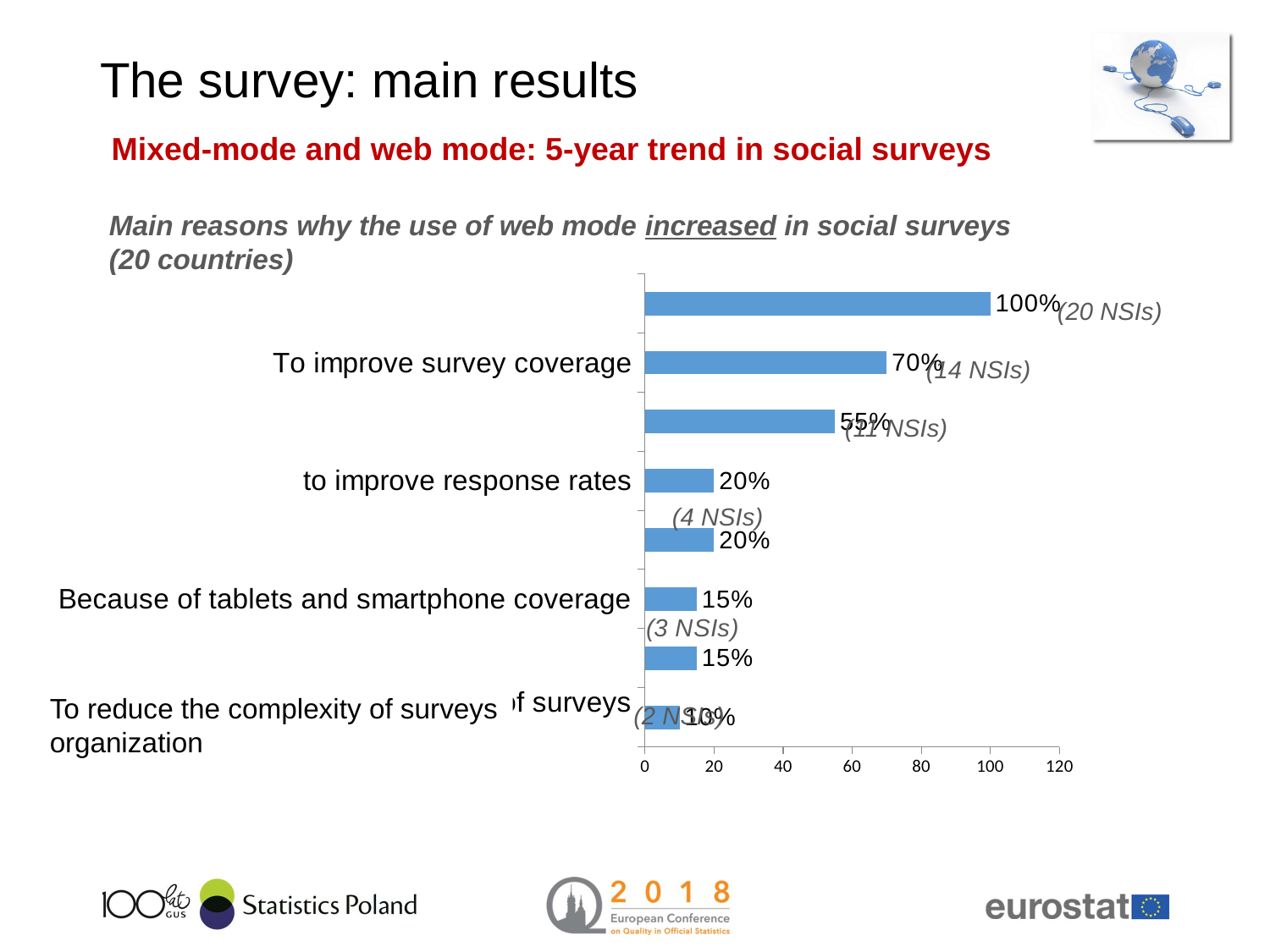
What is the value for "Because of tablets and smartphone coverage"? 15% How many NSIs are indicated next to the bar for "To improve survey coverage"? 14 NSIs Which labelled category has the shortest bar? To reduce the complexity of surveys organization Which is larger: the value for "To improve survey coverage" or for "Because of tablets and smartphone coverage"? To improve survey coverage What is the value for "To improve survey coverage"? 70% What is the value for "to improve response rates"? 20% What is the maximum value shown on the horizontal axis? 120 What is the difference between the values for "To improve survey coverage" and "to improve response rates"? 50 percentage points What is the highest value shown on the chart? 100% How many bars are plotted on the chart? 8 Is the value of the top bar greater or less than 80? greater What kind of chart is shown on the slide? bar chart